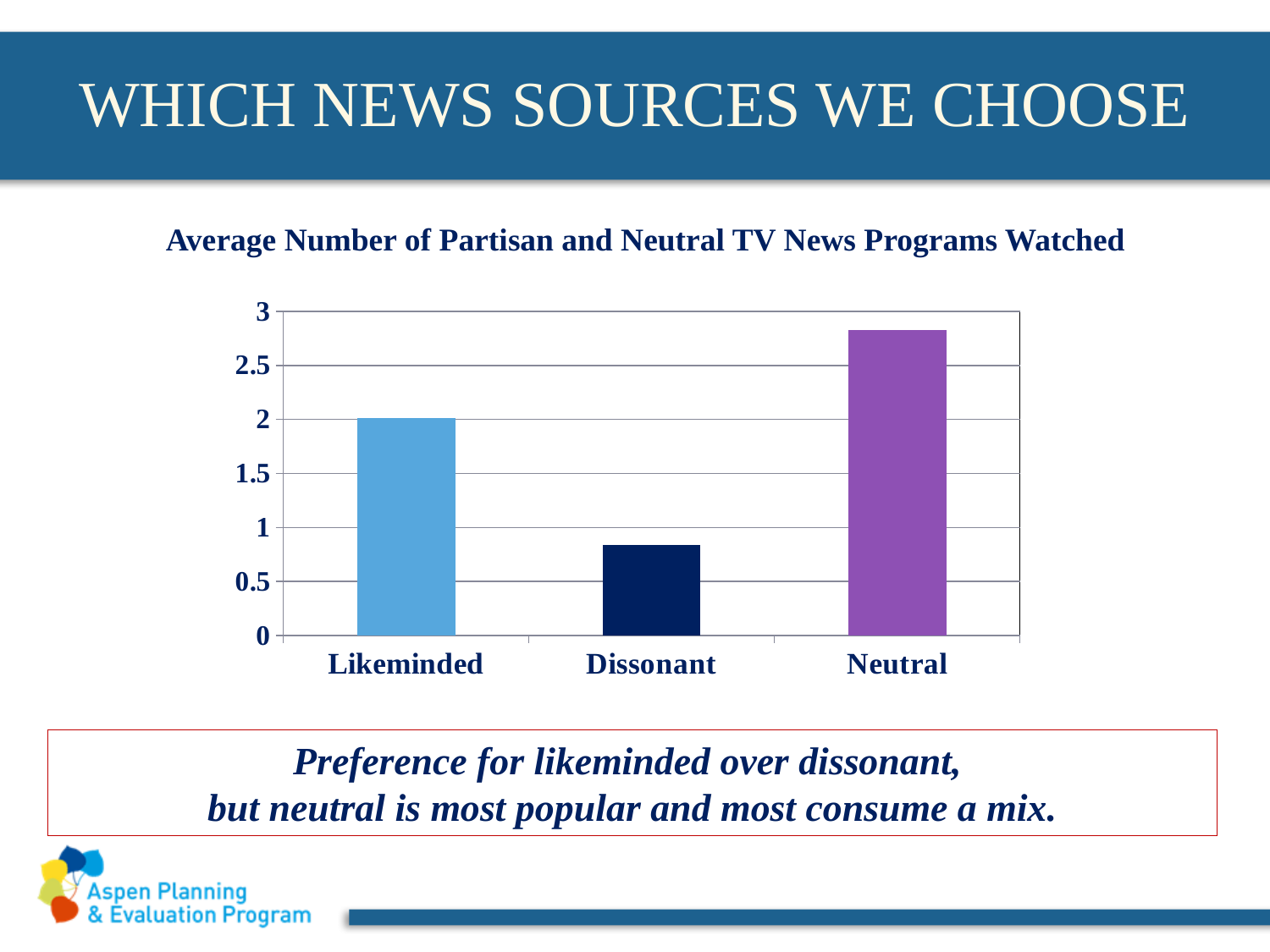
Is the value for Likeminded greater or less than 1.5? greater Is the value for Neutral greater or less than 2.5? greater Which category has the lowest bar in the chart? Dissonant Which category has the highest bar in the chart? Neutral How many categories are shown on the x axis of the chart? 3 Which is larger, the value for Likeminded or the value for Dissonant? Likeminded Which is larger, the value for Neutral or the value for Likeminded? Neutral What is the title of the chart? Average Number of Partisan and Neutral TV News Programs Watched What is the highest value shown on the chart's y axis? 3 Is the value for Neutral greater or less than 3? less What kind of chart is shown on the slide? bar chart